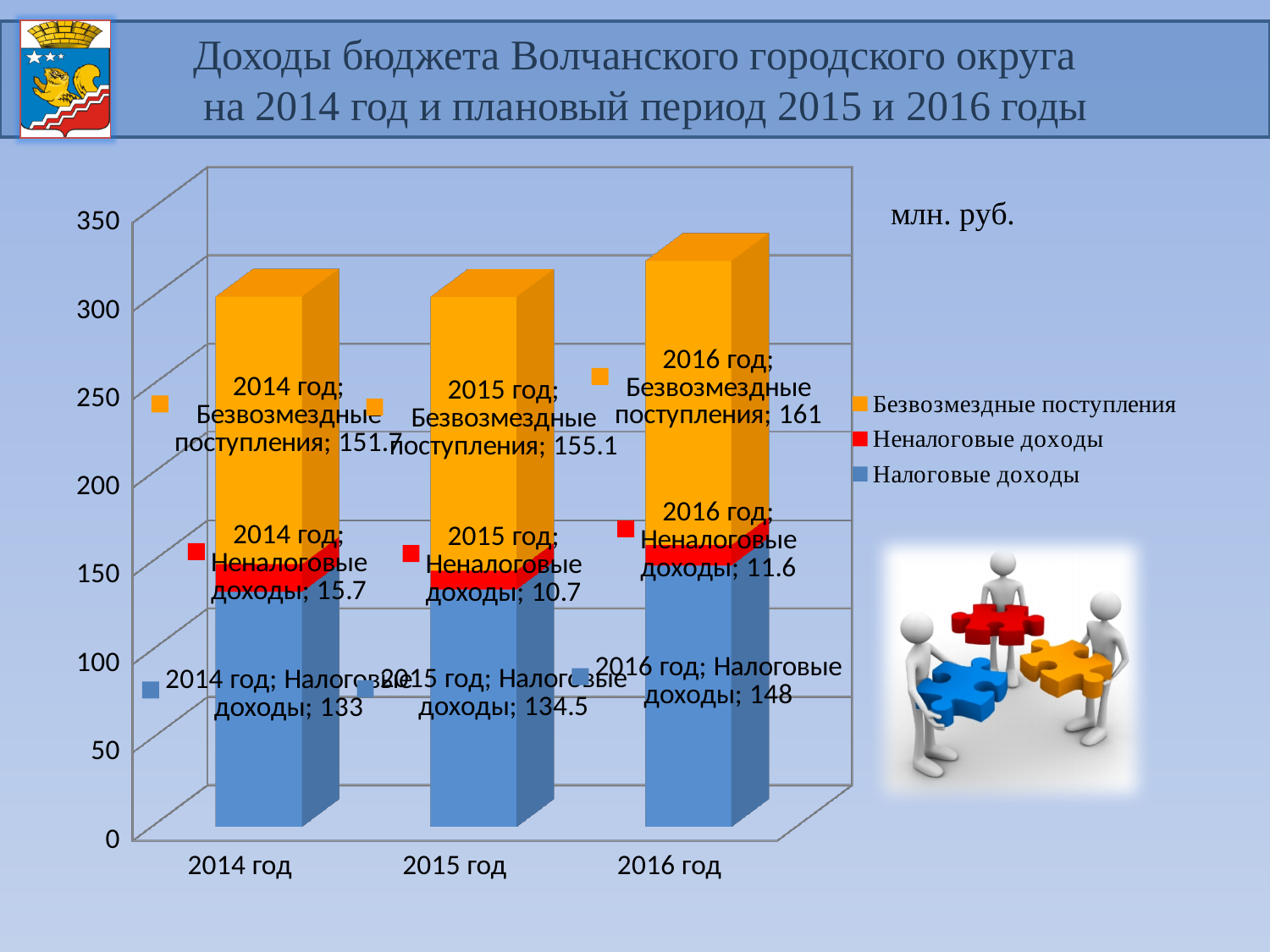
What is the value of Безвозмездные поступления for 2015 год? 155.1 What kind of chart is shown on the slide? Stacked bar chart How many years are shown on the x axis? 3 What is the value of Налоговые доходы for 2014 год? 133 What is the total of the stacked bar for 2016 год? 320.6 What is the difference between Безвозмездные поступления in 2016 год and 2014 год? 9.3 Which year has the lowest value of Неналоговые доходы? 2015 год Which colour represents Безвозмездные поступления in the chart? Orange How many series does the legend list? 3 Which is larger: Налоговые доходы in 2015 год or Налоговые доходы in 2016 год? 2016 год Which year has the highest value of Налоговые доходы? 2016 год What is the value of Неналоговые доходы for 2016 год? 11.6